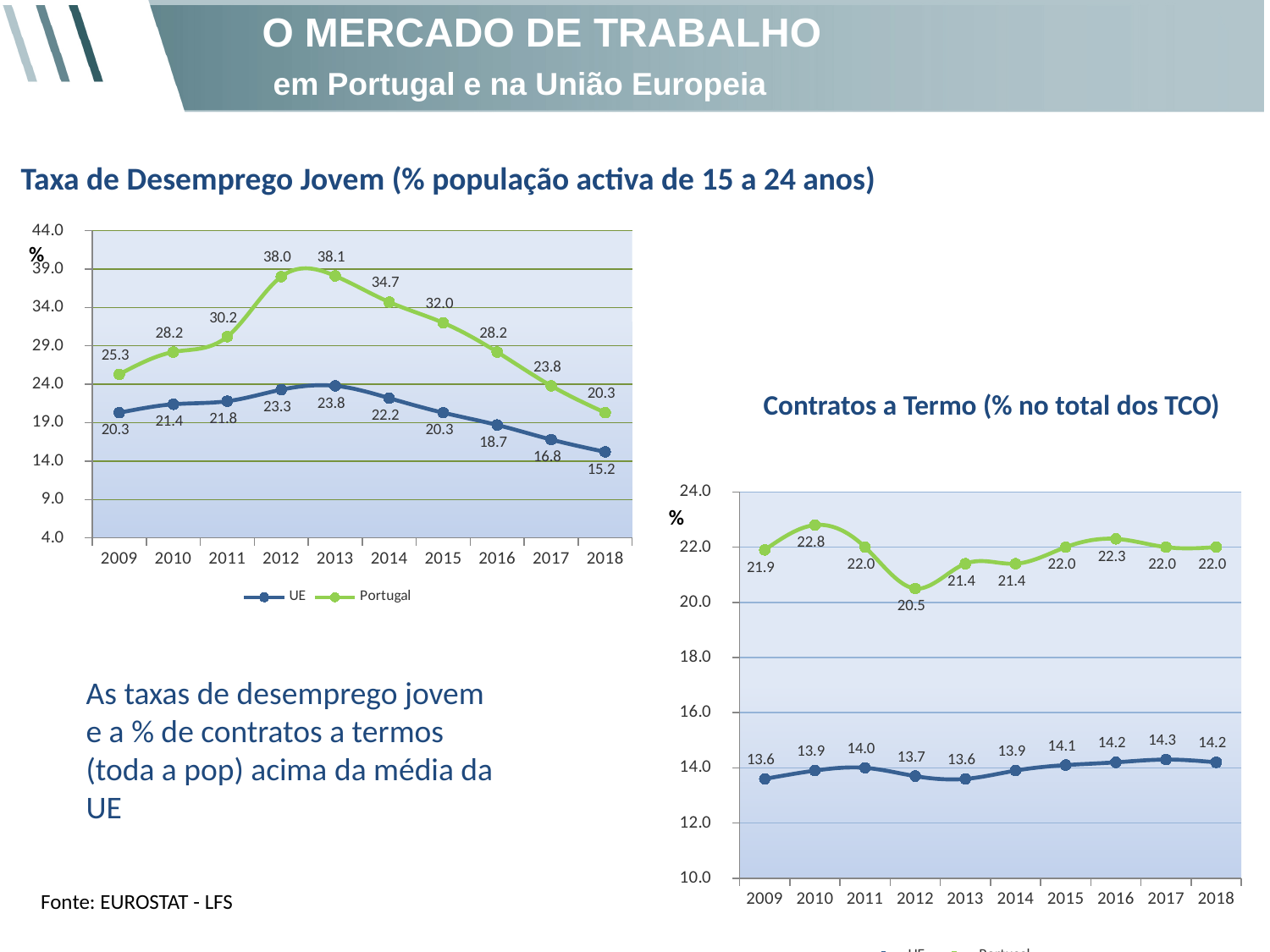
In the 'Contratos a Termo' chart, in which year is the green (Portugal) series highest? 2010 In the 'Taxa de Desemprego Jovem' chart, in which year is the UE series lowest? 2018 In the 'Taxa de Desemprego Jovem' chart, how many series does the legend list? 2 In the 'Taxa de Desemprego Jovem' chart, in which year does the Portugal series reach its highest value? 2013 In the 'Contratos a Termo' chart, what is the value of the green (Portugal) series in 2012? 20.5 In the 'Taxa de Desemprego Jovem' chart, what is the difference between Portugal and UE in 2012? 14.7 In the 'Contratos a Termo' chart, what is the value of the blue (UE) series in 2017? 14.3 In the 'Taxa de Desemprego Jovem' chart, what is the value for UE in 2018? 15.2 What kind of chart is 'Contratos a Termo (% no total dos TCO)'? Line chart In the 'Contratos a Termo' chart, which series is larger in 2018, the green (Portugal) or the blue (UE)? Portugal (green) In the 'Taxa de Desemprego Jovem' chart, what is the value for Portugal in 2013? 38.1 In the 'Taxa de Desemprego Jovem' chart, how many years are shown on the x axis? 10